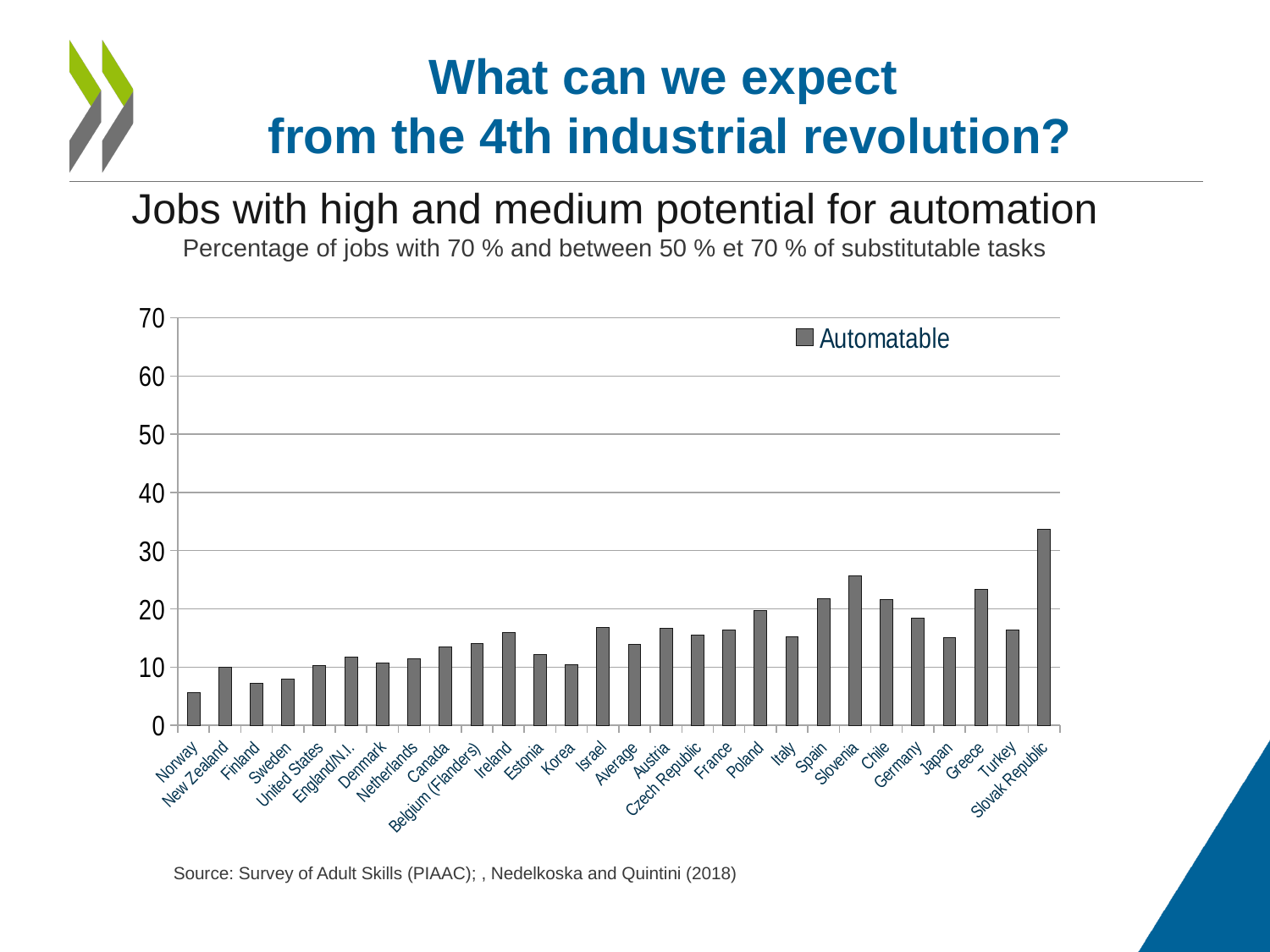
Which has a higher value, Japan or Greece? Greece Is the value for Ireland greater or less than 10? greater How many series does the legend list? 1 How many categories (countries plus the average) are shown on the x axis? 28 Which has a higher value, Slovenia or Greece? Slovenia Is the value for the Slovak Republic greater or less than 30? greater Is the value for Norway greater or less than 10? less Which country has the highest share of automatable jobs in the chart? Slovak Republic What is the name of the series shown in the legend? Automatable What kind of chart is shown on the slide? bar chart Which country has the lowest share of automatable jobs in the chart? Norway